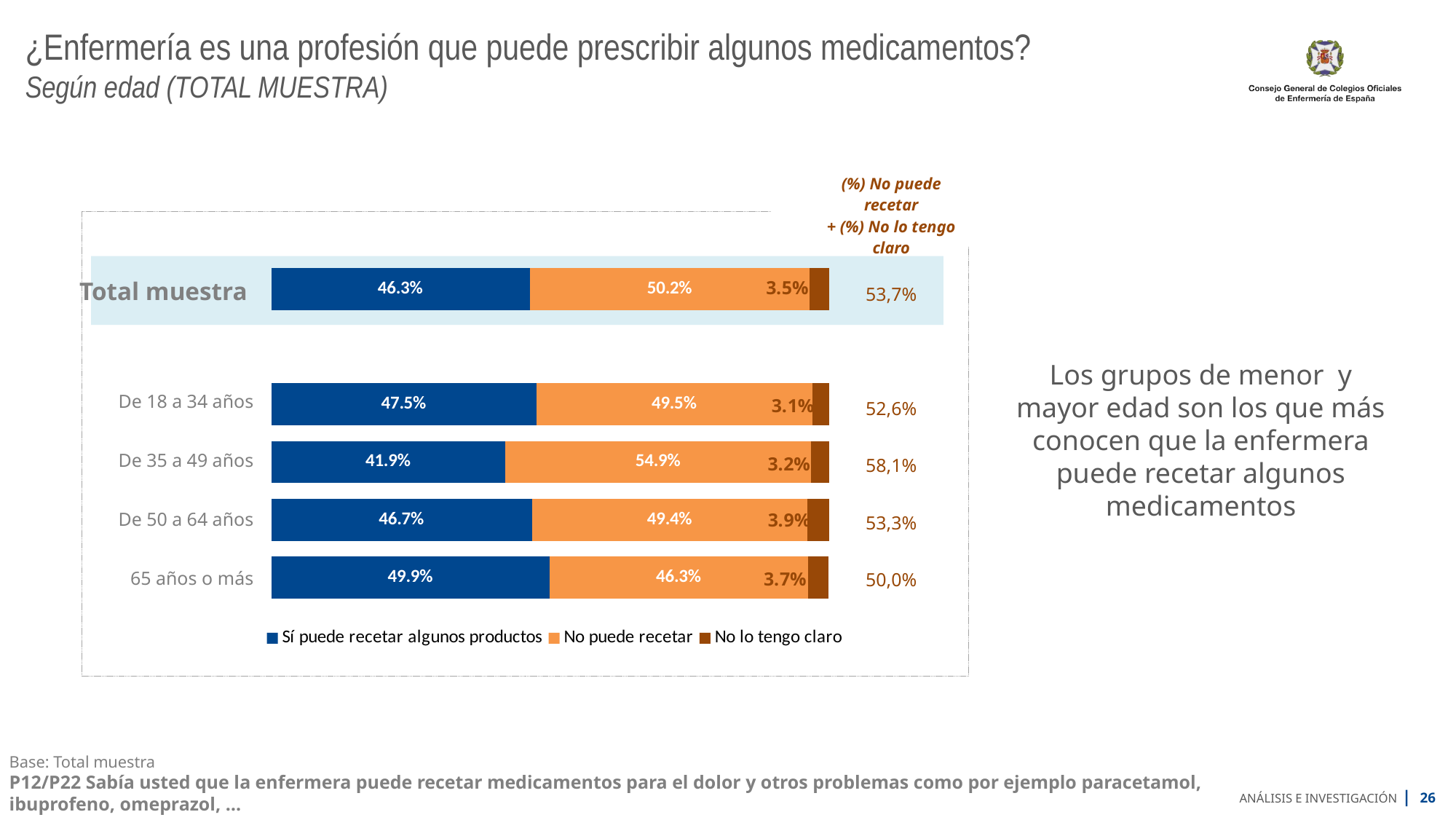
Which age group has the lowest 'Sí puede recetar algunos productos' percentage? De 35 a 49 años What is the 'No lo tengo claro' value for the 'De 50 a 64 años' group? 3.9% Which age group has the highest 'Sí puede recetar algunos productos' percentage? 65 años o más What is the difference between the 'Sí puede recetar algunos productos' values for '65 años o más' and 'De 35 a 49 años'? 8.0 percentage points What is the combined '(%) No puede recetar + (%) No lo tengo claro' figure shown for 'De 35 a 49 años'? 58,1% How many series does the legend list? 3 Which age group has the highest 'No puede recetar' percentage? De 35 a 49 años Which is larger: the 'No puede recetar' value for 'De 18 a 34 años' or for 'De 50 a 64 años'? De 18 a 34 años What type of chart is shown on the slide? Stacked bar chart How many age groups (excluding 'Total muestra') are shown in the chart? 4 What percentage of the 'De 35 a 49 años' group answered 'Sí puede recetar algunos productos'? 41.9% What is the 'No puede recetar' value for the 'Total muestra' bar? 50.2%